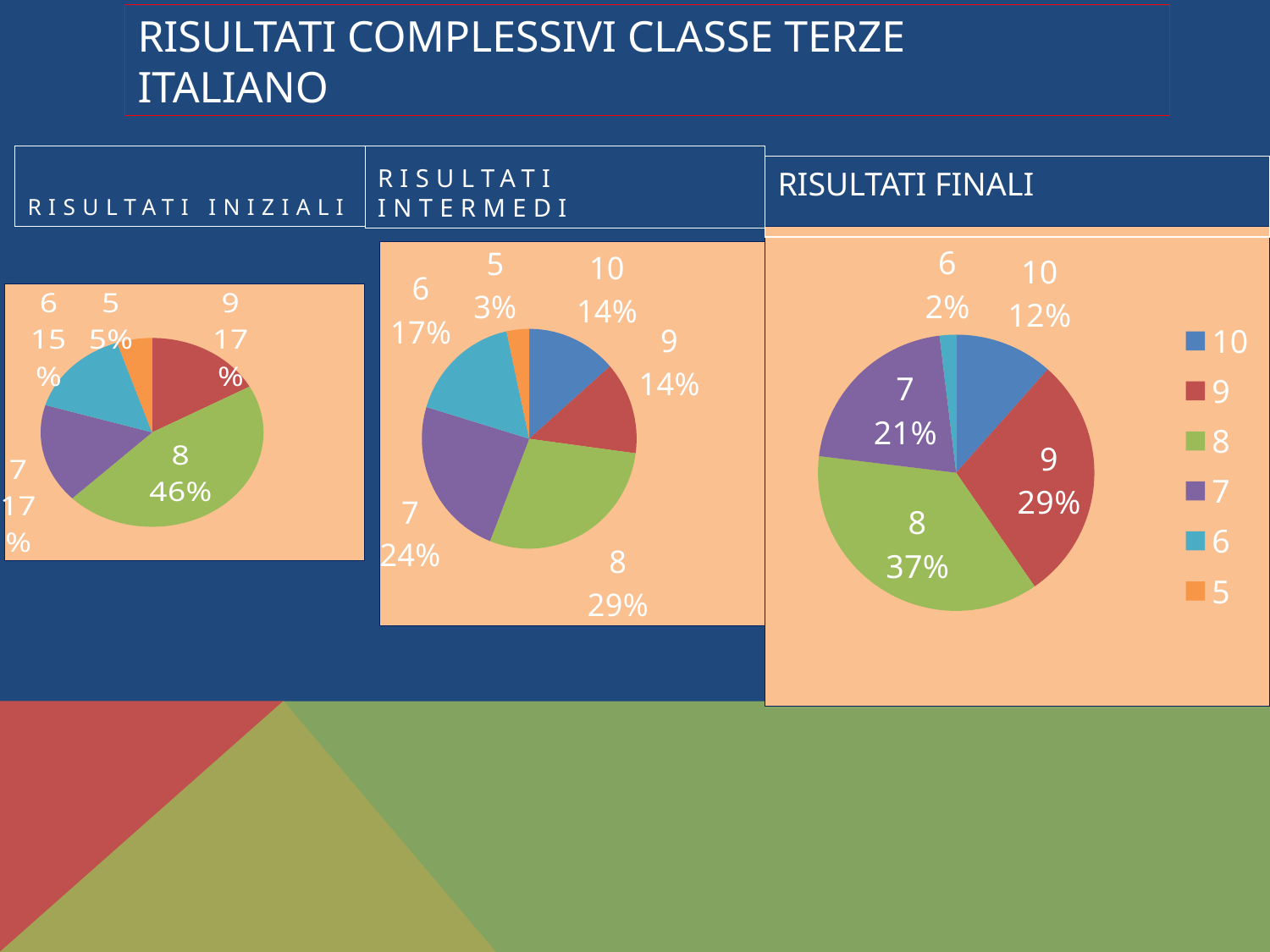
In the RISULTATI INTERMEDI chart, what share does the slice for 5 have? 3% What type of chart is used for RISULTATI FINALI? Pie chart In the RISULTATI INIZIALI chart, what share does the slice for 5 have? 5% In the RISULTATI INIZIALI chart, what share does the slice for 8 have? 46% In the RISULTATI FINALI chart, what share does the slice for 9 have? 29% In the RISULTATI FINALI chart, what share does the slice for 8 have? 37% In the RISULTATI FINALI chart, which category has the largest slice? 8 How many entries does the legend of the RISULTATI FINALI chart list? 6 What is the difference between the share for 8 in the RISULTATI INIZIALI chart and the share for 8 in the RISULTATI FINALI chart? 9% In the RISULTATI INTERMEDI chart, what share does the slice for 7 have? 24% In the RISULTATI INTERMEDI chart, which category has the largest slice? 8 In the RISULTATI FINALI chart, which category has the smallest slice? 6